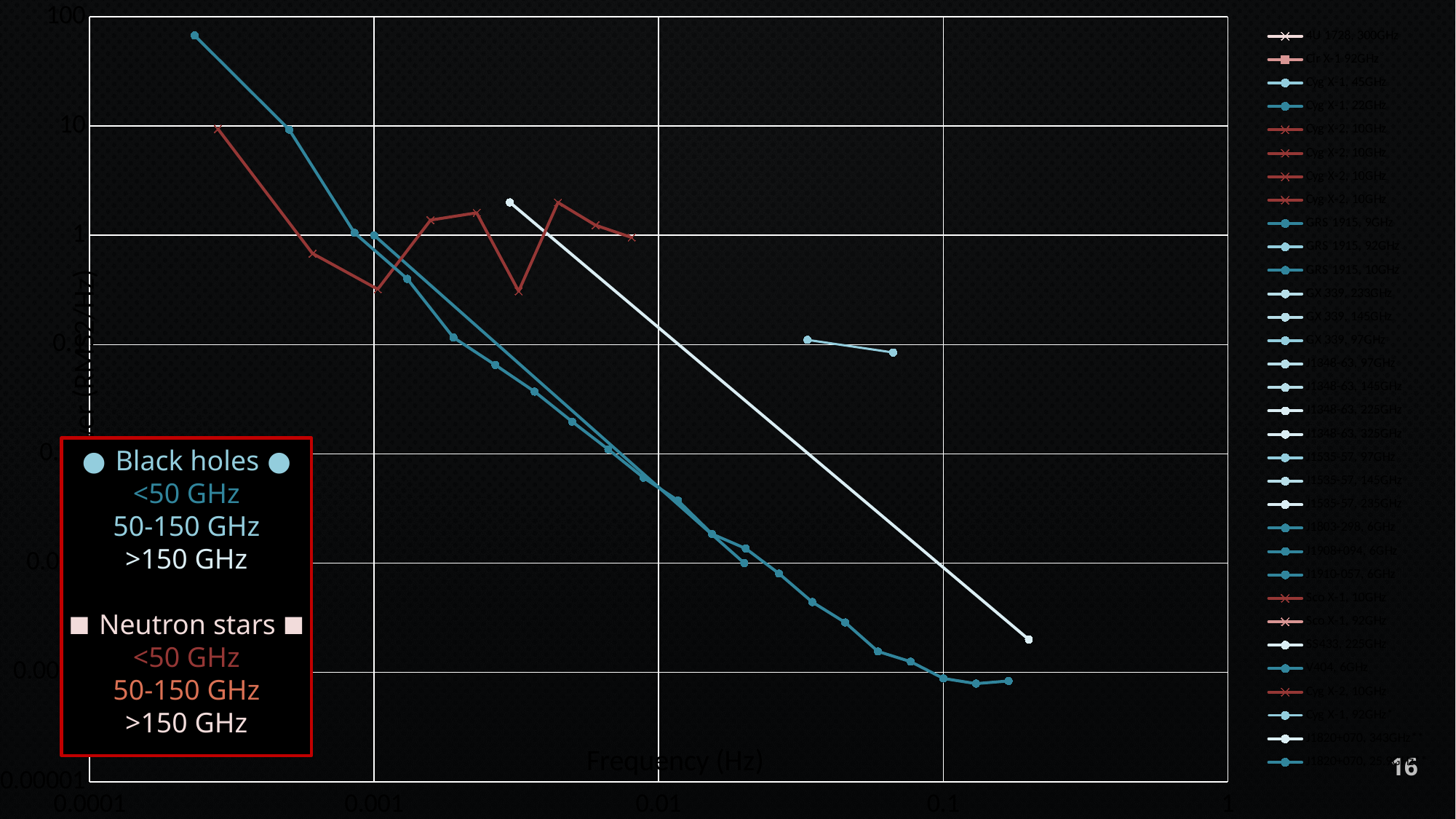
Is the value of the highest teal point, near 0.0002 Hz, greater or less than 10? greater What kind of chart is shown on the slide? line chart What is the label of the x axis? Frequency (Hz) Is the red line's peak near 0.005 Hz greater or less than 1? greater According to the legend box, which marker shape represents black holes? circle How many labelled tick values are shown on the x axis? 5 Is the value at the right-hand end of the white line, near 0.2 Hz, greater or less than 0.01? less Near 0.0002 Hz, which line has the larger value, the teal line or the red line? the teal line Do the values of the long teal black-hole line rise or fall as frequency increases along the x axis? fall What is the largest tick value labelled on the x axis? 1